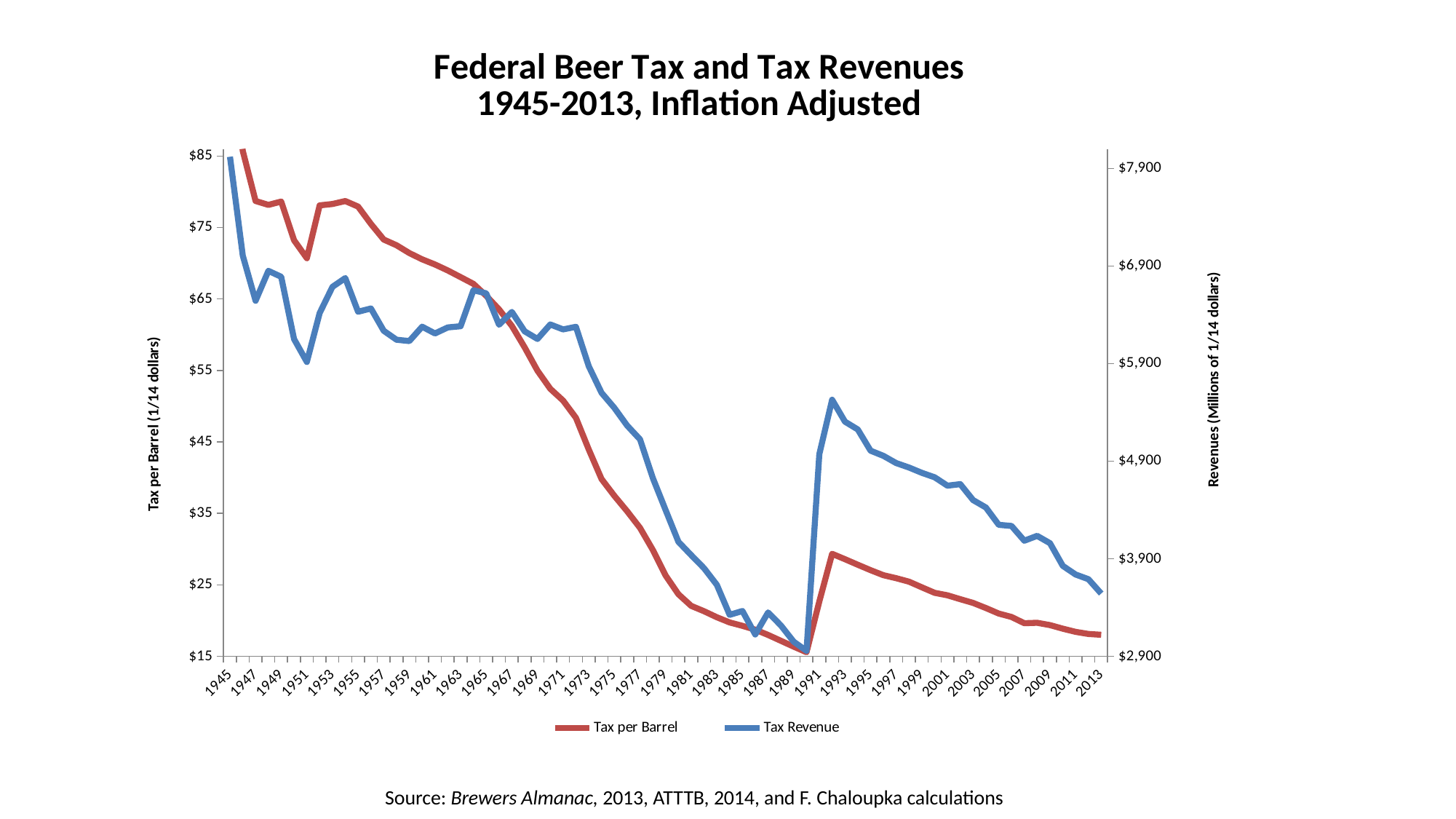
What is the label of the right-hand vertical axis? Revenues (Millions of 1/14 dollars) Which is larger, Tax per Barrel in 1955 or Tax per Barrel in 1975? 1955 How many series does the legend list? 2 Does the Tax Revenue line rise or fall between 1993 and 2013? Fall What kind of chart is shown on the slide? Line chart What are the two series named in the legend? Tax per Barrel and Tax Revenue In which year is Tax Revenue at its highest? 1945 Does the Tax per Barrel line rise or fall between 1945 and 1990? Fall Is the value for Tax Revenue in 1992 greater or less than $4,900? greater Is the value for Tax per Barrel in 1975 greater or less than $45? less In which year is Tax per Barrel at its lowest? 1990 Is the value for Tax Revenue in 2013 greater or less than $3,900? less